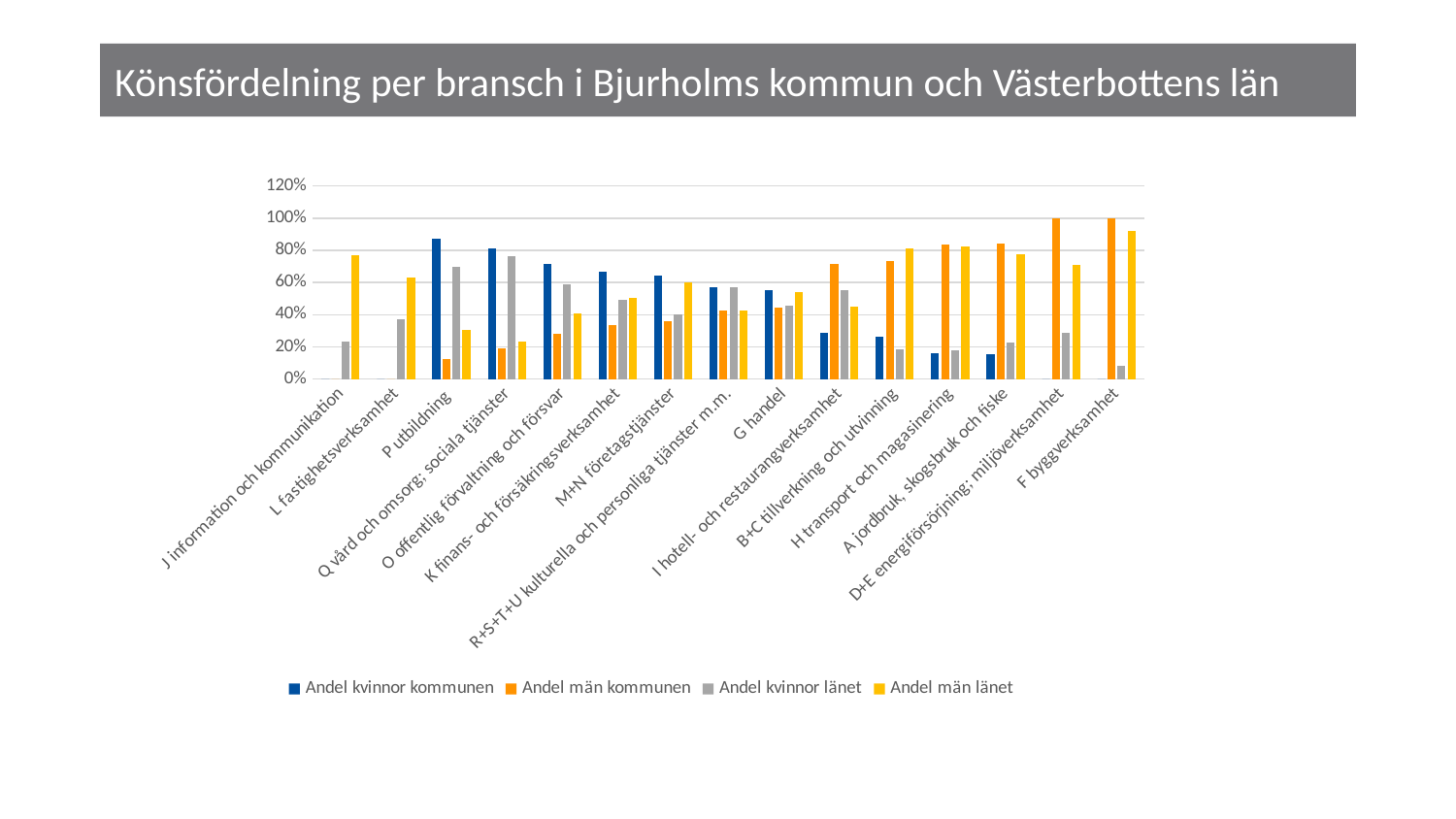
How many series does the legend list? 4 Which category has the lowest value for Andel kvinnor länet? F byggverksamhet What is the title of the chart? Könsfördelning per bransch i Bjurholms kommun och Västerbottens län Is the value of Andel kvinnor kommunen for A jordbruk, skogsbruk och fiske greater or less than 20%? less What is the value of Andel män kommunen for D+E energiförsörjning; miljöverksamhet? 100% Is the value of Andel kvinnor kommunen for P utbildning greater or less than 80%? greater How many industry categories are shown on the x axis? 15 Which category has the highest value for Andel män länet? F byggverksamhet Which series is shown in dark blue in the legend? Andel kvinnor kommunen What kind of chart is shown on the slide? bar chart Is the value of Andel män länet for J information och kommunikation greater or less than 60%? greater For P utbildning, which is larger: Andel kvinnor kommunen or Andel män kommunen? Andel kvinnor kommunen